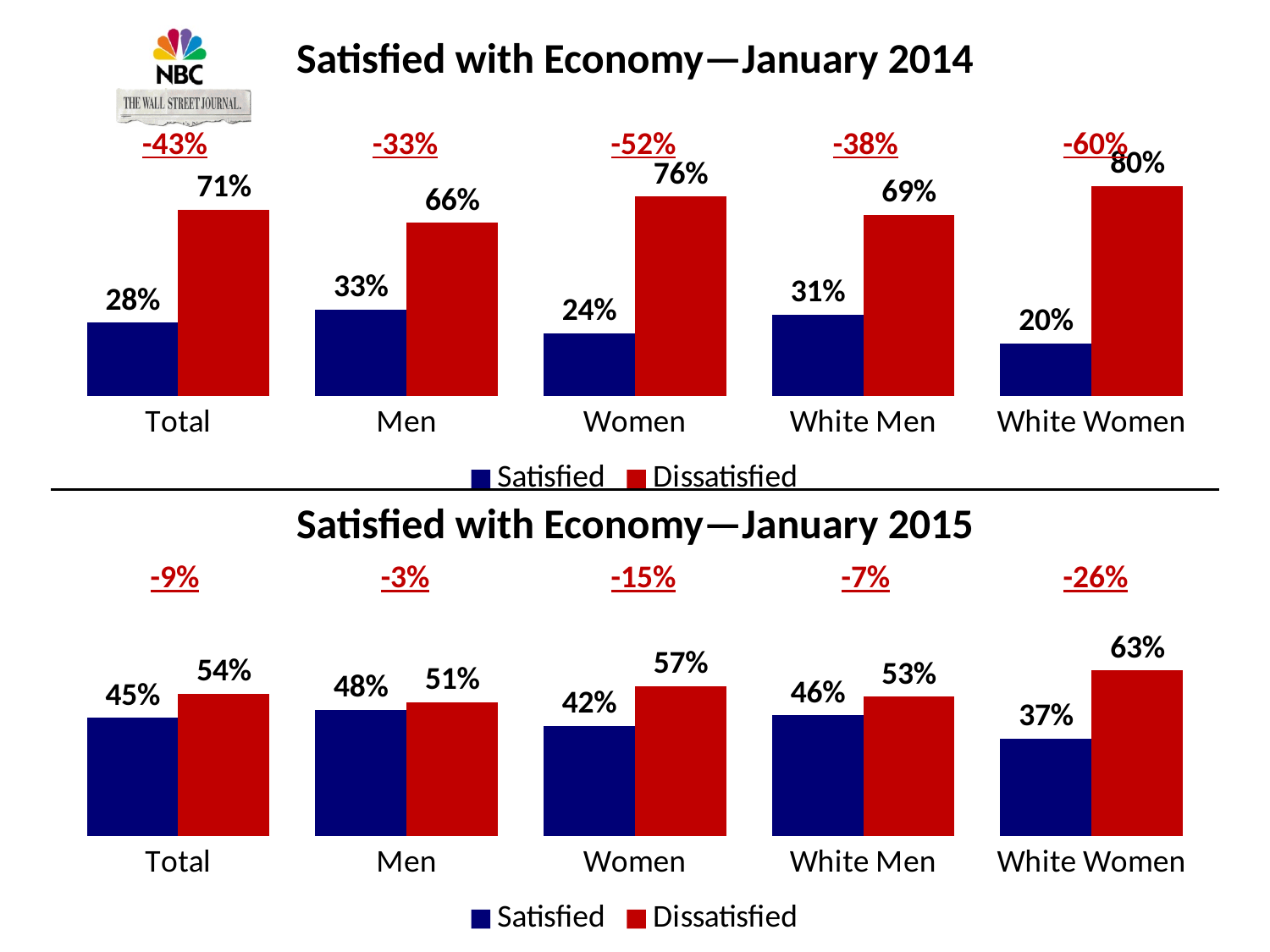
What kind of chart is the 'Satisfied with Economy—January 2014' chart? Bar chart How many series does the legend of the 'Satisfied with Economy—January 2014' chart list? 2 In the 'Satisfied with Economy—January 2014' chart, what is the Dissatisfied value for Women? 76% In the 'Satisfied with Economy—January 2014' chart, what is the Satisfied value for Men? 33% In the 'Satisfied with Economy—January 2015' chart, what is the Satisfied value for Women? 42% In the 'Satisfied with Economy—January 2014' chart, what is the difference between the Dissatisfied and Satisfied values for Total? 43% In the 'Satisfied with Economy—January 2015' chart, what colour are the Dissatisfied bars? Red In the 'Satisfied with Economy—January 2014' chart, which category has the lowest Satisfied value? White Women In the 'Satisfied with Economy—January 2015' chart, which category has the highest Dissatisfied value? White Women In the 'Satisfied with Economy—January 2015' chart, what is the Satisfied value for White Men? 46% In the 'Satisfied with Economy—January 2015' chart, which is larger for Men: the Satisfied value or the Dissatisfied value? Dissatisfied How many categories are shown on the x axis of the 'Satisfied with Economy—January 2015' chart? 5